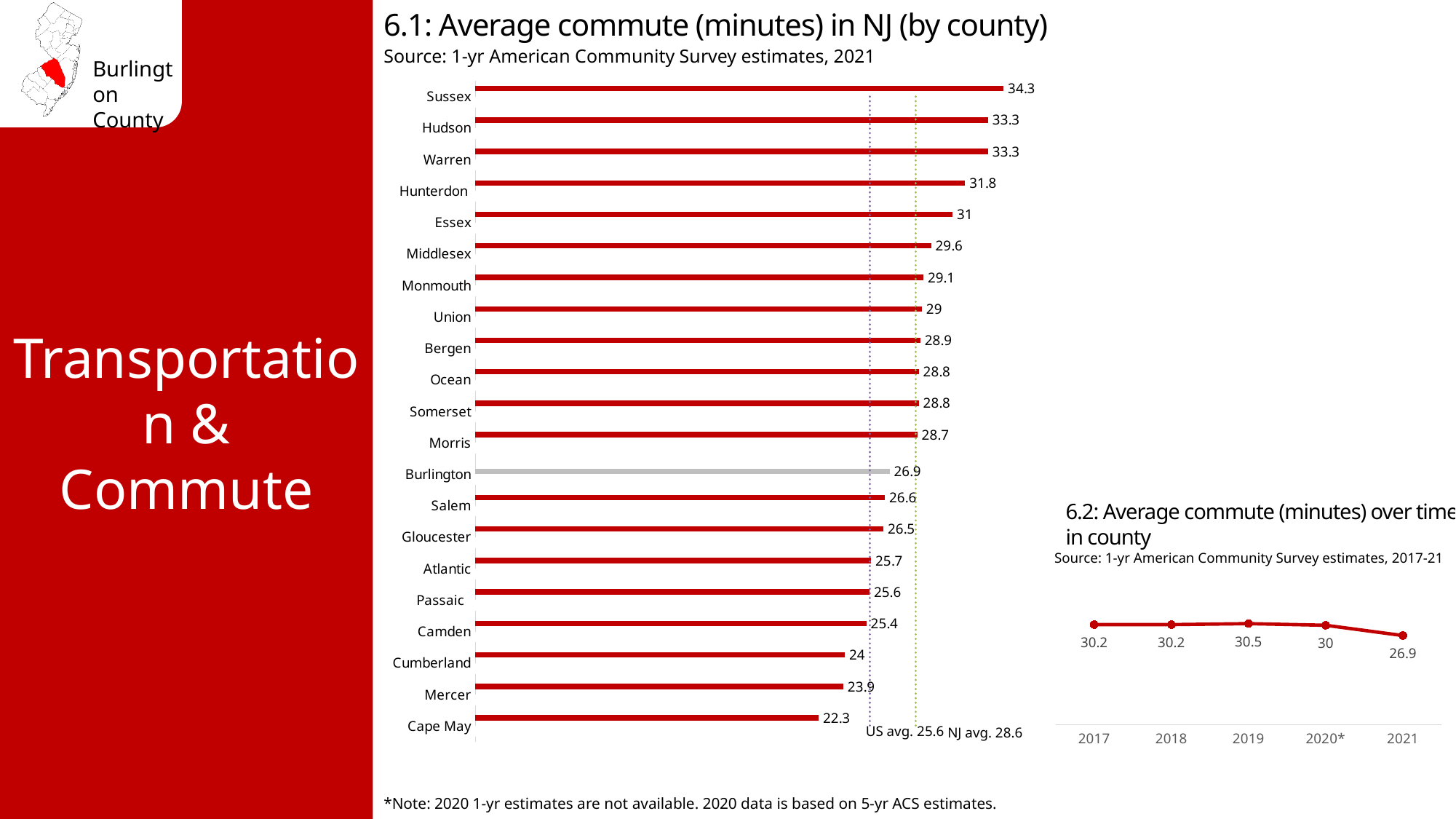
In chart 6.1, what is the average commute for Hunterdon? 31.8 In chart 6.1, what is the difference between the average commute for Sussex and Cape May? 12 In chart 6.2 (Average commute over time in county), what is the value for 2019? 30.5 In chart 6.2, how many data points are plotted? 5 What kind of chart is chart 6.1? bar chart In chart 6.1 (Average commute in NJ by county), what is the average commute for Burlington? 26.9 In chart 6.1, how many counties are shown? 21 In chart 6.1, which county has the highest average commute? Sussex In chart 6.1, which county has the lowest average commute? Cape May In chart 6.1, what NJ average commute is indicated by the dotted reference line? 28.6 In chart 6.1, which has a longer average commute, Essex or Middlesex? Essex In chart 6.2, what is the difference between the 2020* value and the 2021 value? 3.1